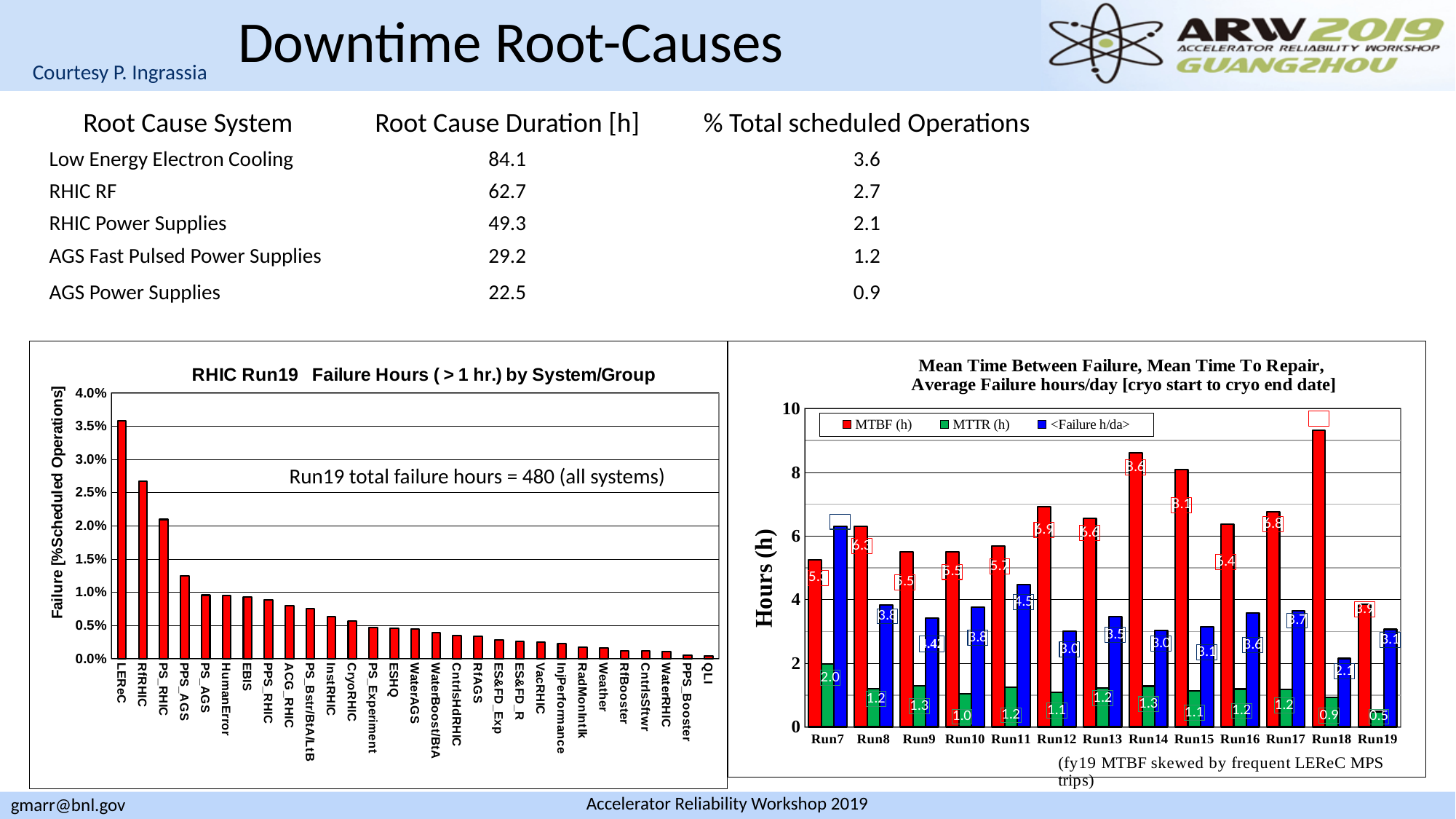
In the left chart, RHIC Run19 Failure Hours by System/Group, do the bars rise or fall from left to right? fall In the right chart, which run has the lowest MTTR (h)? Run19 In the right chart, what is the MTTR (h) value for Run7? 2.0 In the left chart, RHIC Run19 Failure Hours by System/Group, which system/group has the highest failure percentage? LEReC In the right chart, what is the <Failure h/da> value for Run11? 4.5 How many runs are shown on the x axis of the right chart (Mean Time Between Failure, Mean Time To Repair, Average Failure hours/day)? 13 In the left chart, RHIC Run19 Failure Hours by System/Group, is the value for LEReC greater or less than 3.0%? greater How many series does the legend of the right chart (Mean Time Between Failure, Mean Time To Repair, Average Failure hours/day) list? 3 In the left chart, RHIC Run19 Failure Hours by System/Group, is the value for PPS_AGS greater or less than 1.0%? greater In the right chart, what is the MTBF (h) value for Run14? 8.6 In the right chart, what is the difference between the MTBF (h) values for Run14 and Run15? 0.5 What kind of chart is the right chart (Mean Time Between Failure, Mean Time To Repair, Average Failure hours/day)? bar chart